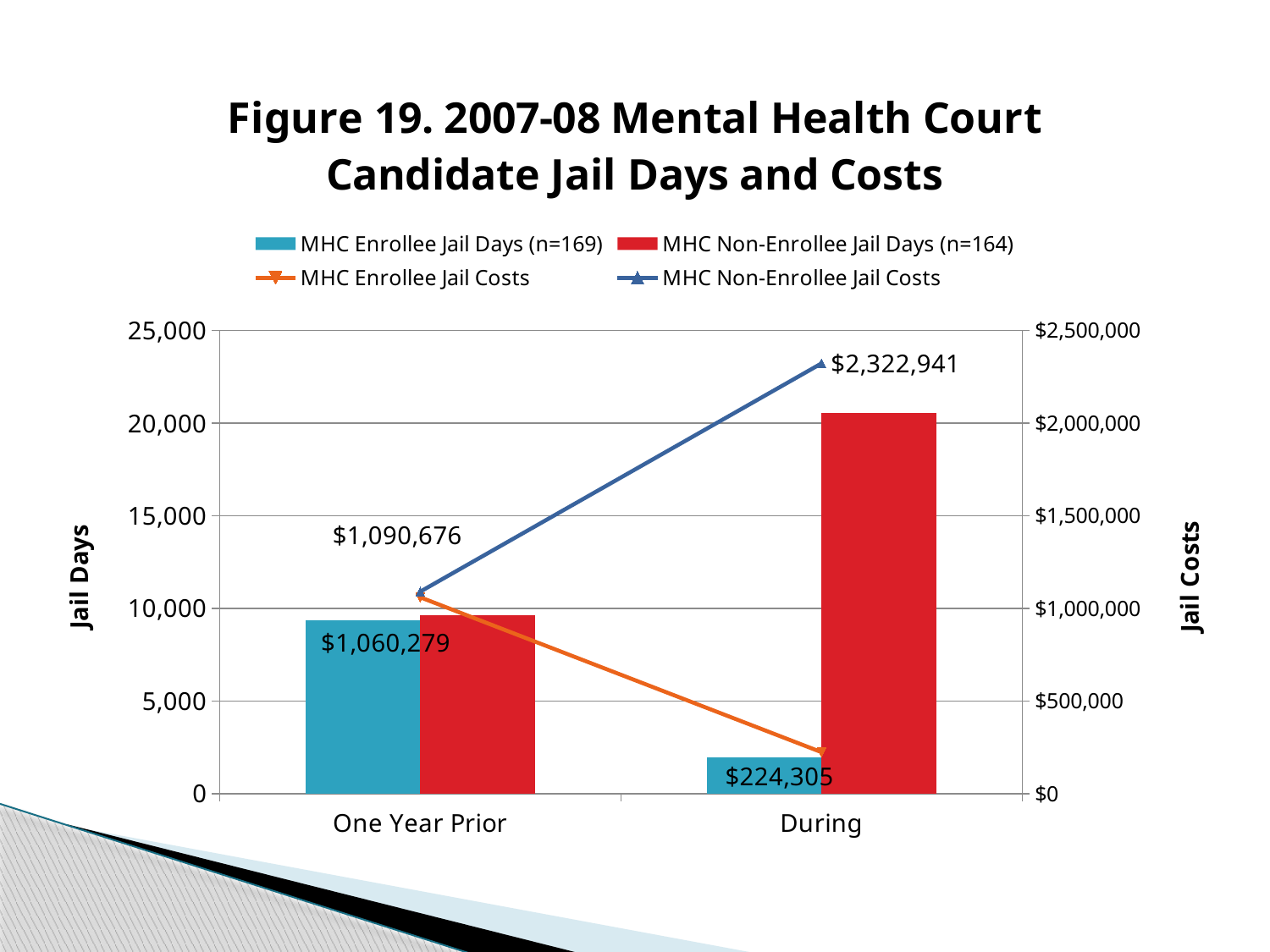
How many categories are shown on the x axis? 2 What is the value of MHC Enrollee Jail Costs for One Year Prior? $1,060,279 By how much did MHC Enrollee Jail Costs decrease from One Year Prior to During? $835,974 What is the value of MHC Non-Enrollee Jail Costs for the During period? $2,322,941 What is the value of MHC Enrollee Jail Costs for the During period? $224,305 Is the value for MHC Enrollee Jail Days during the During period greater or less than 5,000? less What is the value of MHC Non-Enrollee Jail Costs for One Year Prior? $1,090,676 Is the value for MHC Non-Enrollee Jail Days during the During period greater or less than 20,000? greater Do MHC Enrollee Jail Costs rise or fall from One Year Prior to During? fall Which is larger in the During period: MHC Enrollee Jail Days or MHC Non-Enrollee Jail Days? MHC Non-Enrollee Jail Days How many series does the legend list? 4 By how much did MHC Non-Enrollee Jail Costs increase from One Year Prior to During? $1,232,265